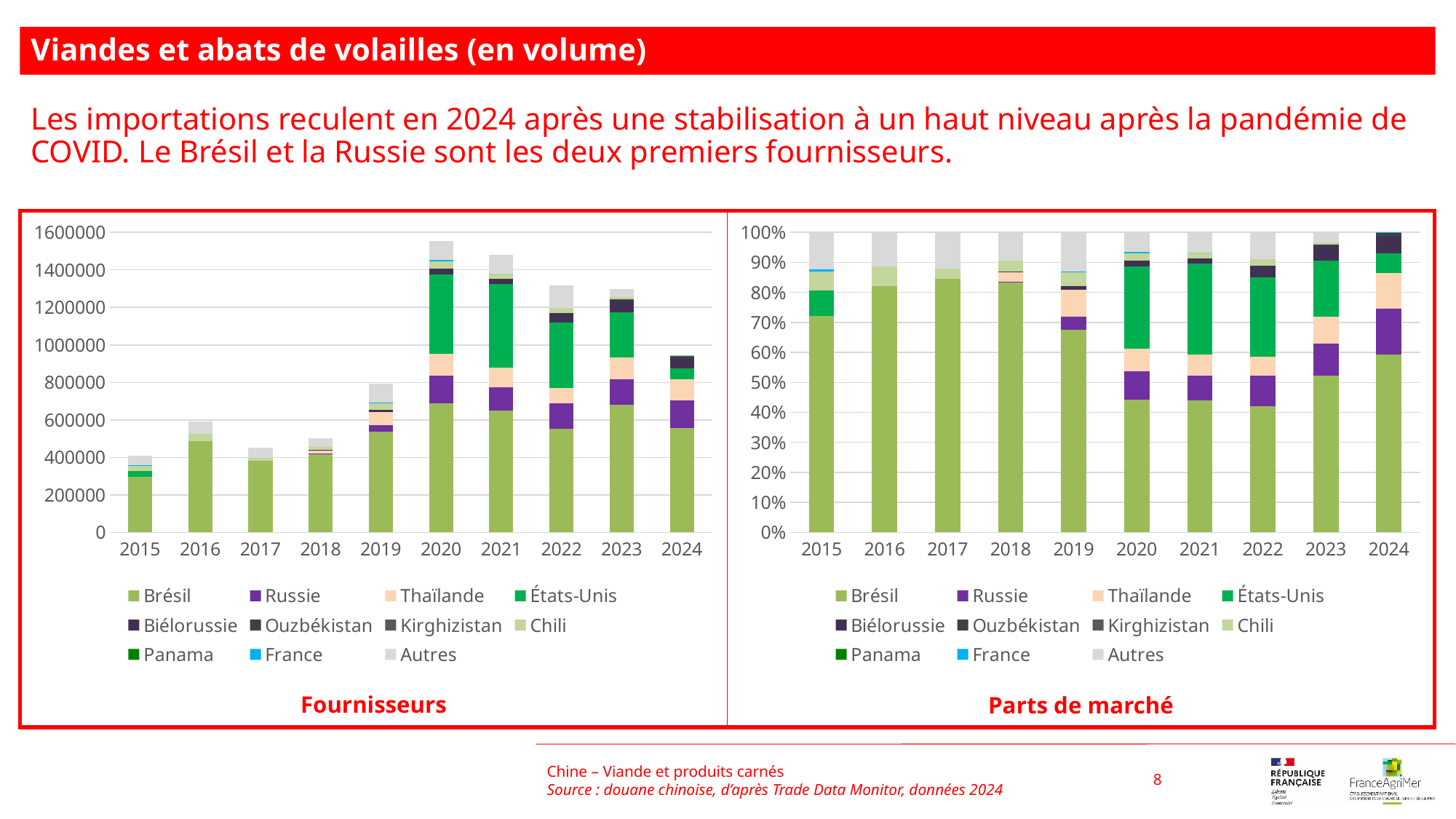
In the "Fournisseurs" chart, which year has the larger total bar, 2021 or 2022? 2021 In the "Fournisseurs" chart, is the total for 2020 greater or less than 1400000? greater In the "Fournisseurs" chart, do the total bars rise or fall from 2017 to 2020? rise How many series does the legend of the "Parts de marché" chart list? 11 In the "Fournisseurs" chart, is the total for 2015 greater or less than 600000? less In the "Parts de marché" chart, is the share of Brésil in 2016 greater or less than 80%? greater What kind of chart is the left chart titled "Fournisseurs"? stacked bar chart How many years are shown on the x axis of the "Fournisseurs" chart? 10 In the "Fournisseurs" chart, which year has the tallest stacked bar? 2020 What is the title shown under the right chart? Parts de marché